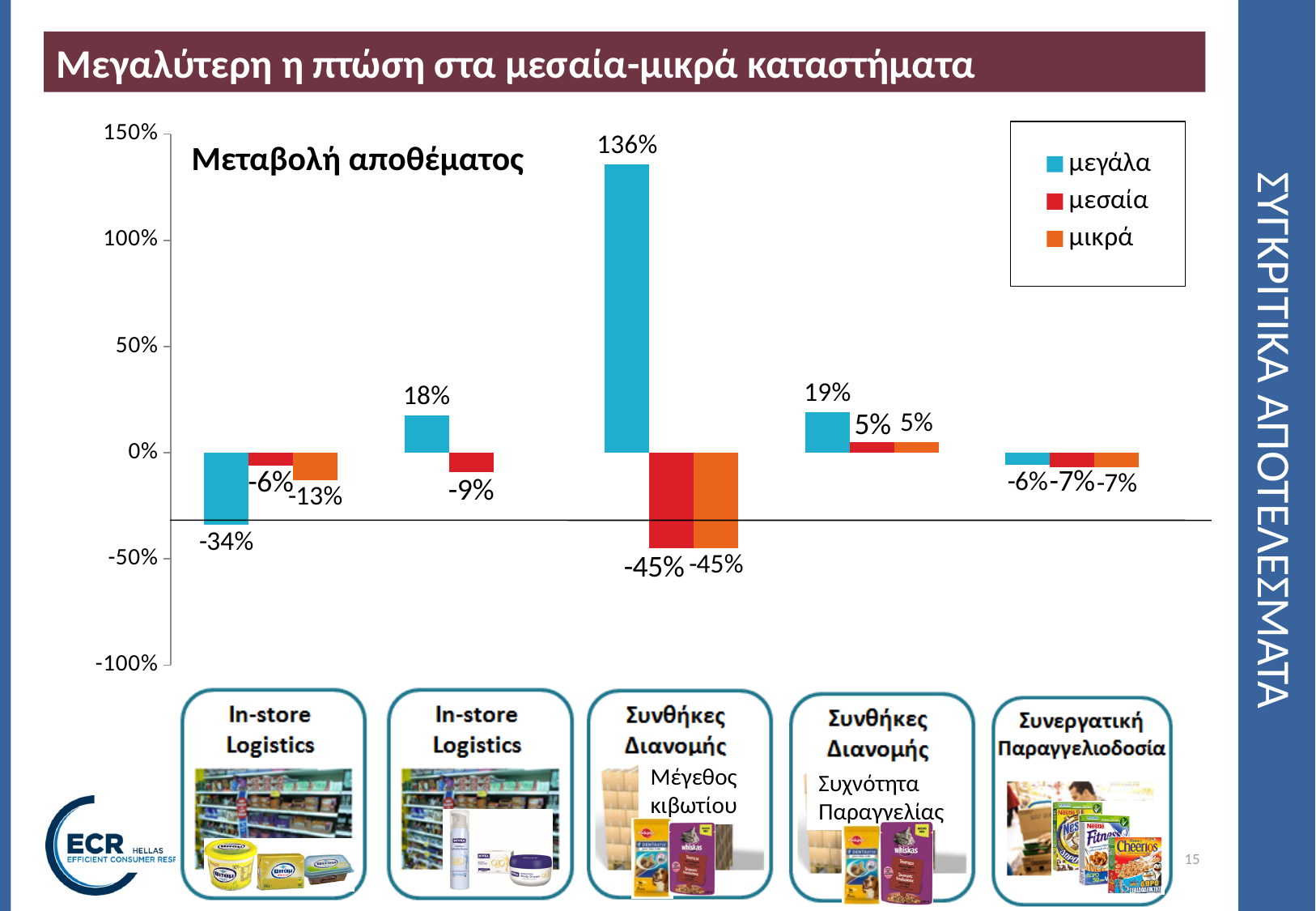
What is the value for μικρά in the Συχνότητα Παραγγελίας category? 5% Which category has the highest value for μεγάλα? Μέγεθος κιβωτίου What is the value for μικρά in the leftmost In-store Logistics category? -13% Is the value for μεγάλα in the Μέγεθος κιβωτίου category greater or less than 100%? greater What kind of chart is shown on the slide? bar chart How many series does the legend list? 3 In the leftmost In-store Logistics category, which is larger: the value for μεγάλα or the value for μικρά? μικρά What is the value for μεσαία in the Συνεργατική Παραγγελιοδοσία category? -7% What is the value for μεγάλα in the Μέγεθος κιβωτίου category? 136% What is the title of the chart? Μεταβολή αποθέματος What is the difference between the μεγάλα value and the μεσαία value in the Μέγεθος κιβωτίου category? 181 percentage points Which category has the lowest value for μεσαία? Μέγεθος κιβωτίου